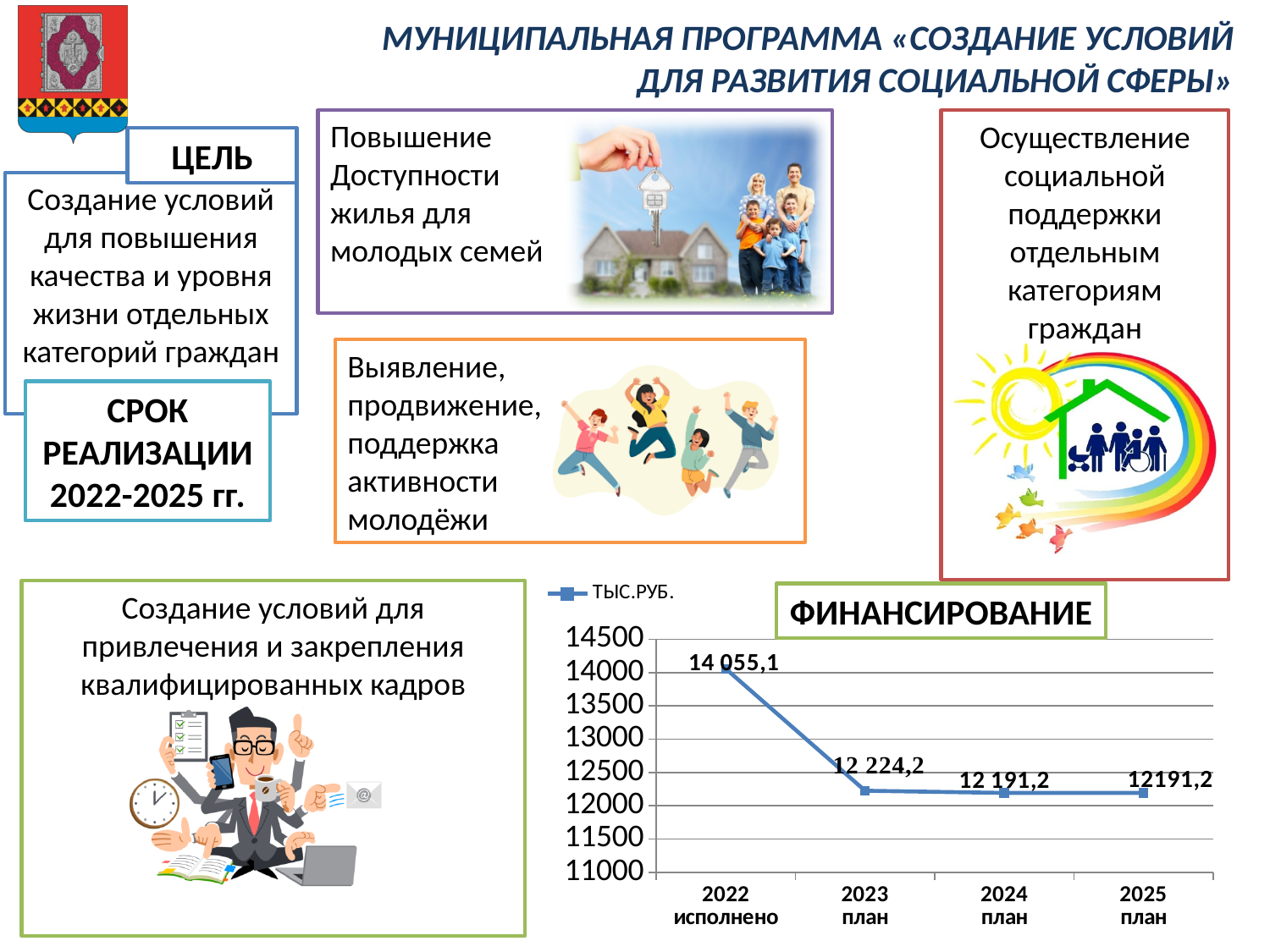
How many data points are plotted on the ФИНАНСИРОВАНИЕ chart? 4 What is the difference between the 2022 исполнено and 2023 план values on the ФИНАНСИРОВАНИЕ chart? 1 830,9 What is the value for 2023 план on the ФИНАНСИРОВАНИЕ chart? 12 224,2 What is the value for 2024 план on the ФИНАНСИРОВАНИЕ chart? 12 191,2 Is the value for 2023 план on the ФИНАНСИРОВАНИЕ chart greater or less than 12500? less What kind of chart is the ФИНАНСИРОВАНИЕ chart? line chart What is the value for 2025 план on the ФИНАНСИРОВАНИЕ chart? 12191,2 Which year has the highest value on the ФИНАНСИРОВАНИЕ chart? 2022 исполнено Which is larger on the ФИНАНСИРОВАНИЕ chart: the value for 2022 исполнено or for 2023 план? 2022 исполнено How many series does the legend of the ФИНАНСИРОВАНИЕ chart list? 1 What is the value for 2022 исполнено on the ФИНАНСИРОВАНИЕ chart? 14 055,1 Do the values on the ФИНАНСИРОВАНИЕ chart rise or fall from 2022 to 2023? fall